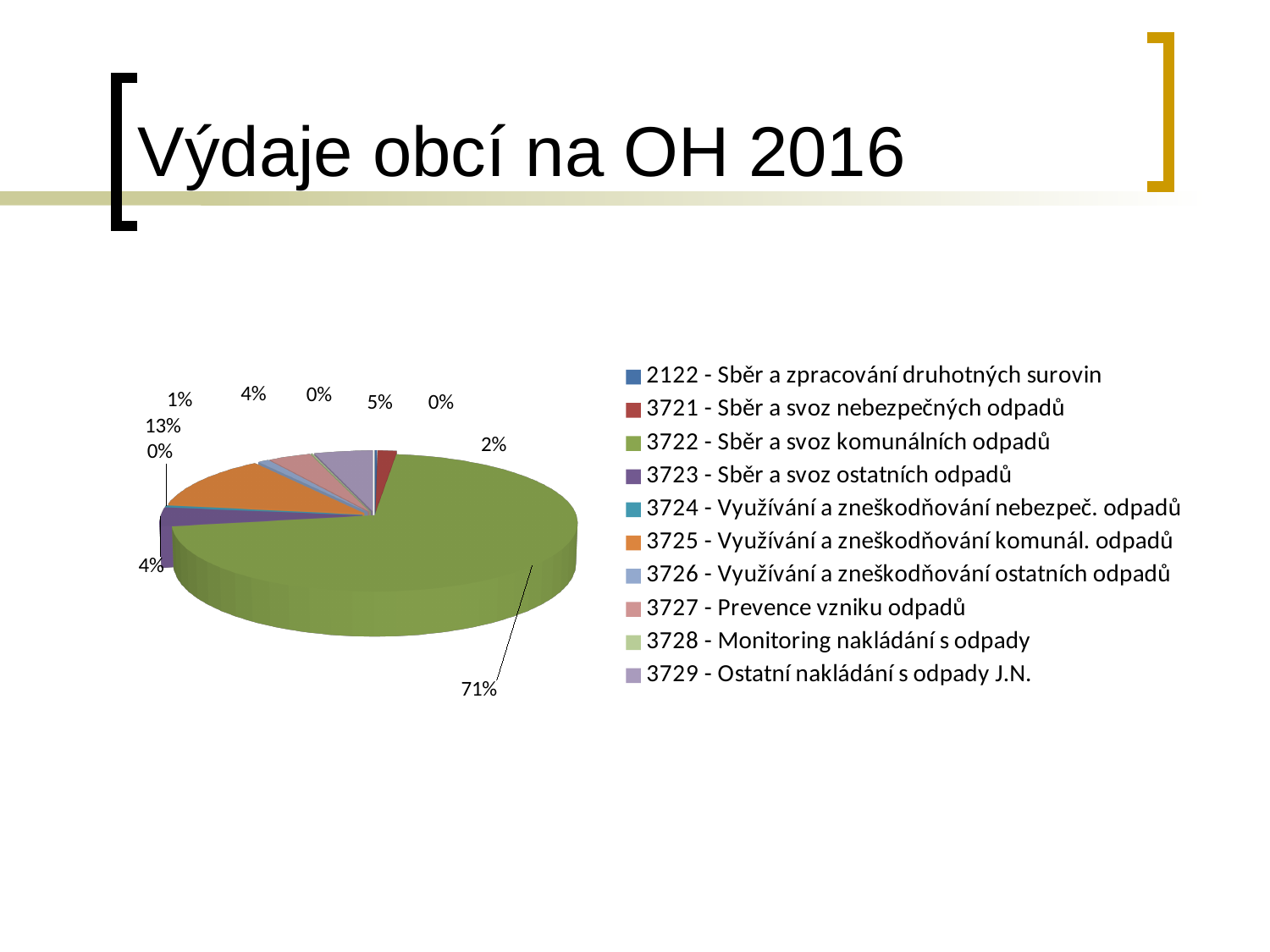
What is the value shown for '3725 - Využívání a zneškodňování komunál. odpadů'? 13% Which category has the largest slice of the pie? 3722 - Sběr a svoz komunálních odpadů Is the share for '3722 - Sběr a svoz komunálních odpadů' greater or less than 50%? greater Which is larger: the slice for '3725 - Využívání a zneškodňování komunál. odpadů' or the slice for '3729 - Ostatní nakládání s odpady J.N.'? 3725 - Využívání a zneškodňování komunál. odpadů What colour is the largest slice of the pie chart? green What is the value shown for '3729 - Ostatní nakládání s odpady J.N.'? 5% How many entries does the legend of the pie chart list? 10 What kind of chart is shown on the slide? pie chart What is the value shown for '3721 - Sběr a svoz nebezpečných odpadů'? 2% What share of the pie does '3722 - Sběr a svoz komunálních odpadů' have? 71% By how many percentage points does the slice for '3722 - Sběr a svoz komunálních odpadů' exceed the slice for '3725 - Využívání a zneškodňování komunál. odpadů'? 58 percentage points What is the title of the slide with the pie chart? Výdaje obcí na OH 2016